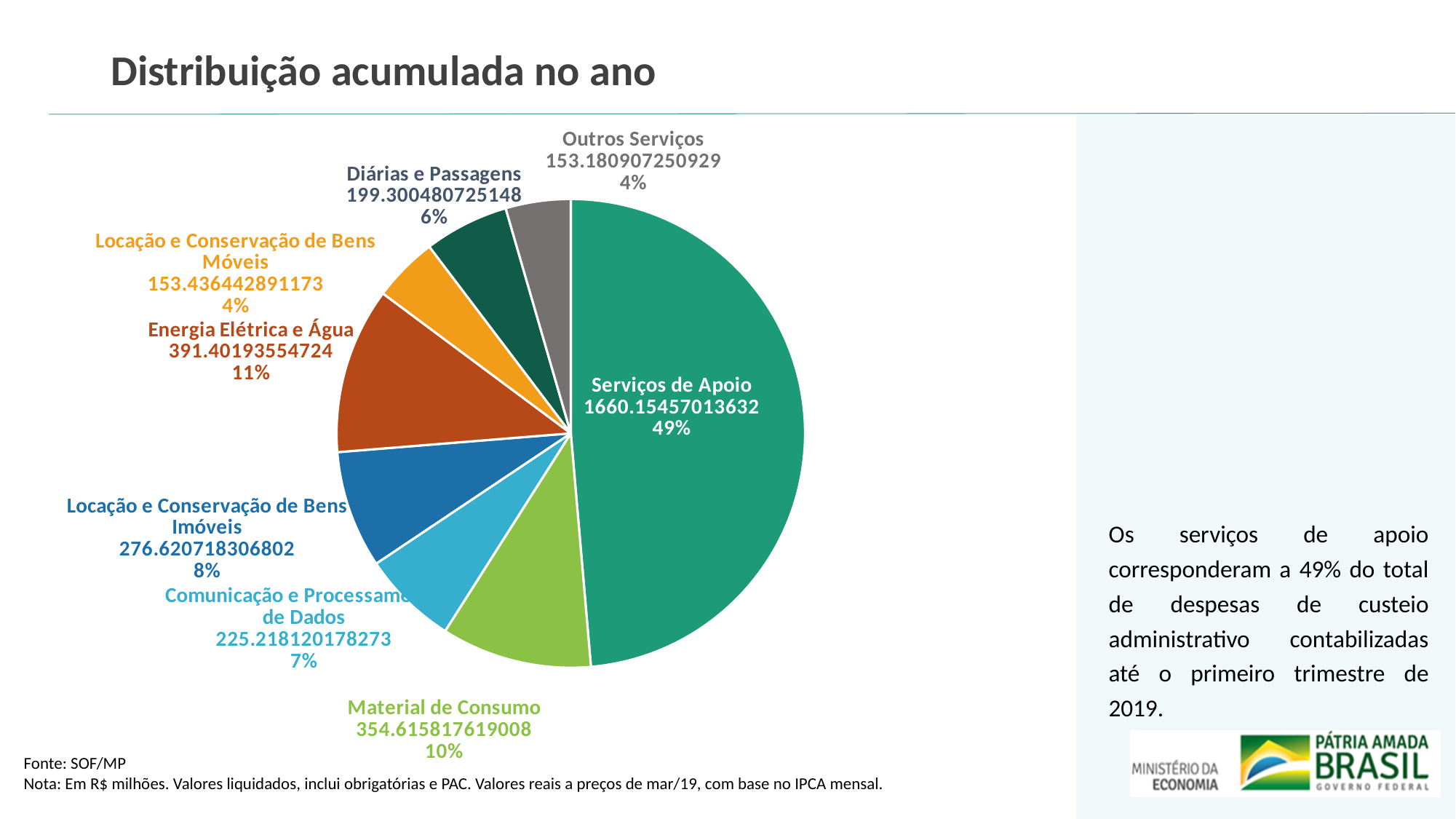
What kind of chart is shown on the slide? Pie chart What is the value shown for Serviços de Apoio? 1660.15457013632 What is the difference between the values for Diárias e Passagens and Outros Serviços? 46.119573474219 Which is larger, Energia Elétrica e Água or Material de Consumo? Energia Elétrica e Água How many slices does the pie chart have? 8 What source is cited for the chart? SOF/MP What percentage is shown for Locação e Conservação de Bens Imóveis? 8% What is the value shown for Energia Elétrica e Água? 391.40193554724 What percentage is shown for Material de Consumo? 10% Which category has the largest slice of the pie? Serviços de Apoio What is the title of the chart on the slide? Distribuição acumulada no ano What share of the pie does Serviços de Apoio represent? 49%